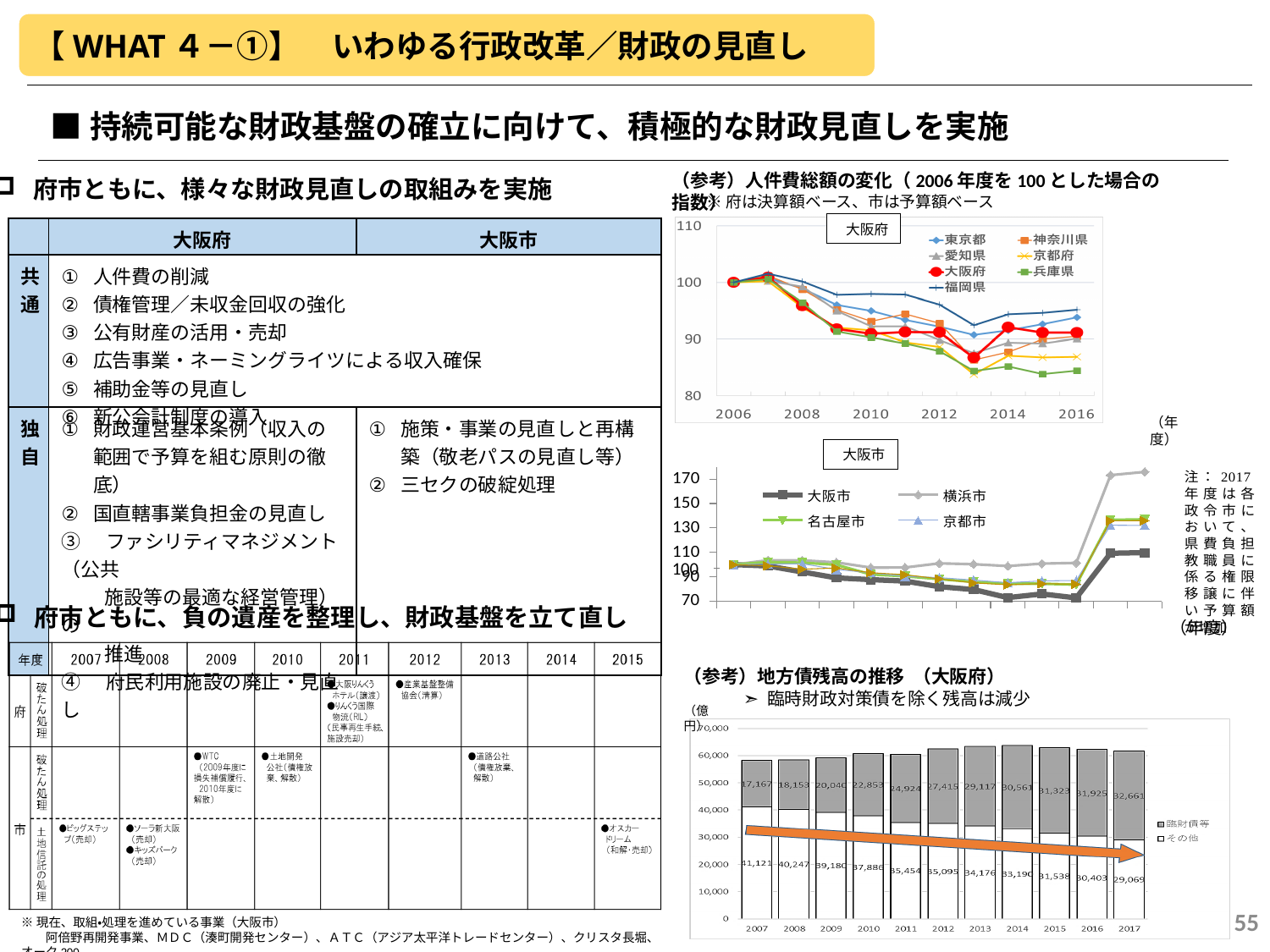
In the bottom-right chart titled （参考）地方債残高の推移（大阪府）, what is the difference between the その他 values for 2007 and 2017? 12,052 In the top-right line chart labelled 大阪府, how many series does the legend list? 7 In the bottom-right chart titled （参考）地方債残高の推移（大阪府）, which year has the highest value for 臨財債等? 2017 In the bottom-right chart titled （参考）地方債残高の推移（大阪府）, how many years are shown on the x axis? 11 What kind of chart is the bottom-right chart titled （参考）地方債残高の推移（大阪府）? Stacked bar chart In the top-right line chart labelled 大阪府, is the value for 大阪府 in 2013 greater or less than 90? less In the bottom-right chart titled （参考）地方債残高の推移（大阪府）, which year has the lowest value for その他? 2017 In the middle-right line chart labelled 大阪市, which city has the highest value in 2017? 横浜市 In the bottom-right chart titled （参考）地方債残高の推移（大阪府）, how does the その他 series change from 2007 to 2017? It falls In the bottom-right chart titled （参考）地方債残高の推移（大阪府）, what is the total of the stacked bar for 2007? 58,288 In the bottom-right chart titled （参考）地方債残高の推移（大阪府）, what is the value of 臨財債等 for 2007? 17,167 In the bottom-right chart titled （参考）地方債残高の推移（大阪府）, what is the value of その他 for 2017? 29,069